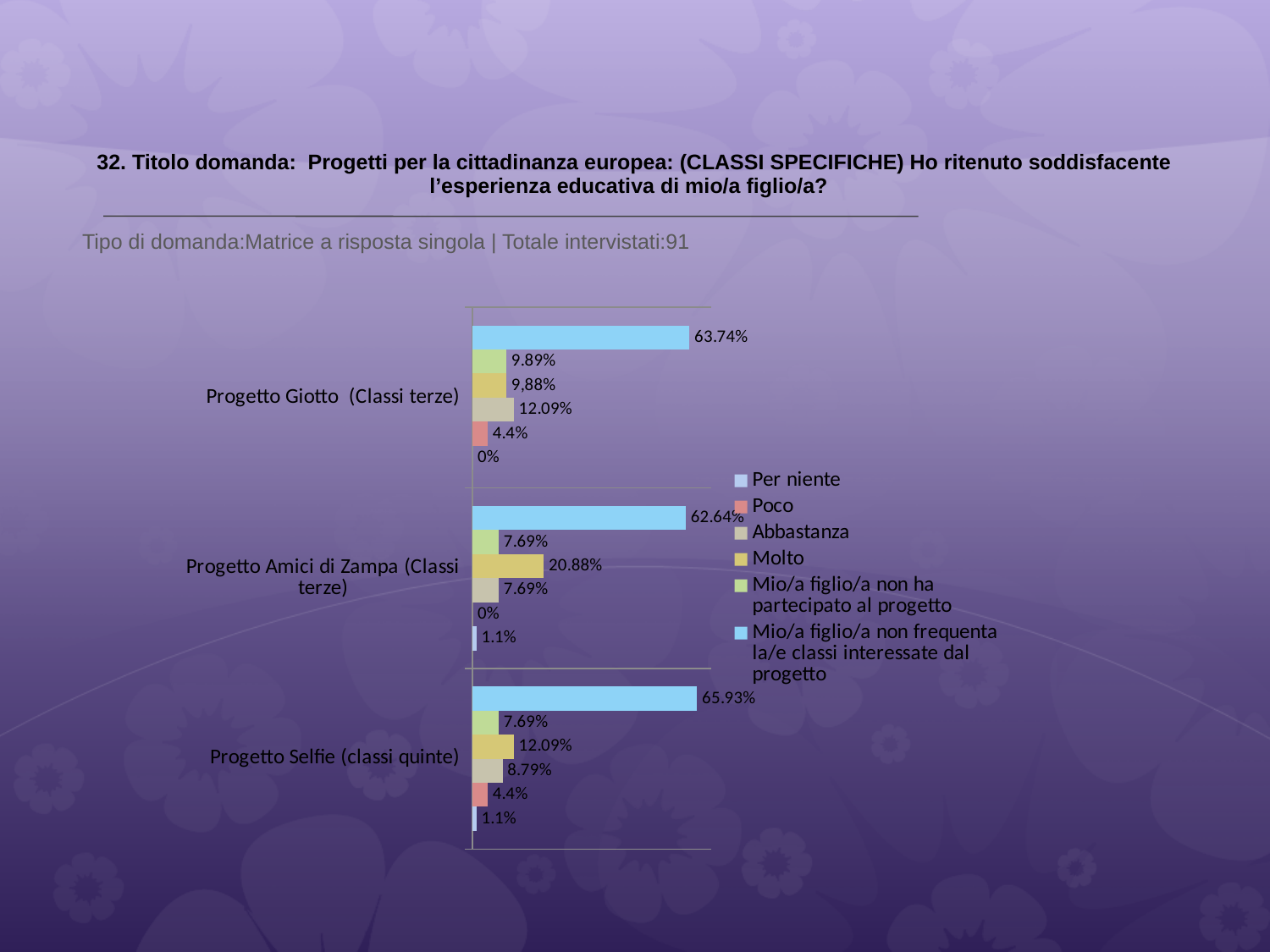
What kind of chart is shown on the slide? bar chart Which project has the highest value for "Molto"? Progetto Amici di Zampa (Classi terze) What is the value for "Per niente" for Progetto Selfie (classi quinte)? 1.1% What is the value for "Molto" for Progetto Amici di Zampa (Classi terze)? 20.88% What is the difference between the "Molto" values for Progetto Amici di Zampa (Classi terze) and Progetto Selfie (classi quinte)? 8.79% Which is larger for Progetto Giotto (Classi terze): the value for "Abbastanza" or the value for "Poco"? Abbastanza How many project categories are shown on the chart? 3 How many series does the legend list? 6 Which project has the highest value for "Mio/a figlio/a non frequenta la/e classi interessate dal progetto"? Progetto Selfie (classi quinte) What is the value for "Abbastanza" for Progetto Giotto (Classi terze)? 12.09% What is the value for "Mio/a figlio/a non frequenta la/e classi interessate dal progetto" for Progetto Selfie (classi quinte)? 65.93% What is the value for "Poco" for Progetto Amici di Zampa (Classi terze)? 0%